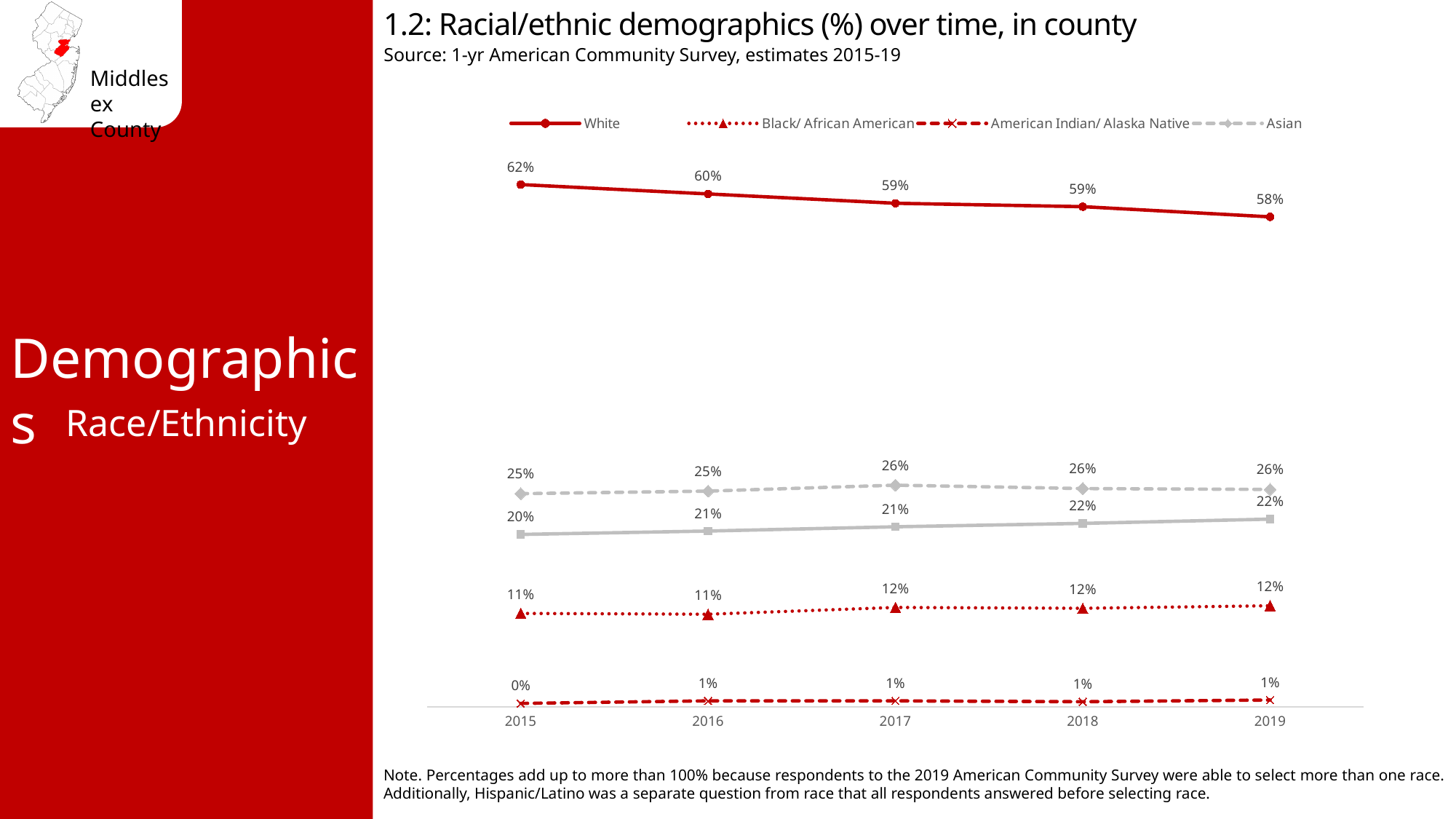
What is the value for White in 2015? 62% What kind of chart is shown on the slide? line chart How many years are shown on the x axis? 5 How many series does the legend list? 4 What is the value for American Indian/ Alaska Native in 2015? 0% In which year is the White series at its highest? 2015 What is the value for Black/ African American in 2017? 12% What is the difference between the White value in 2015 and in 2019? 4% What is the source cited under the chart title? 1-yr American Community Survey, estimates 2015-19 Which is larger in 2018, the Asian value or the Black/ African American value? Asian Does the White series rise or fall from 2015 to 2019? fall What is the value for Asian in 2019? 26%